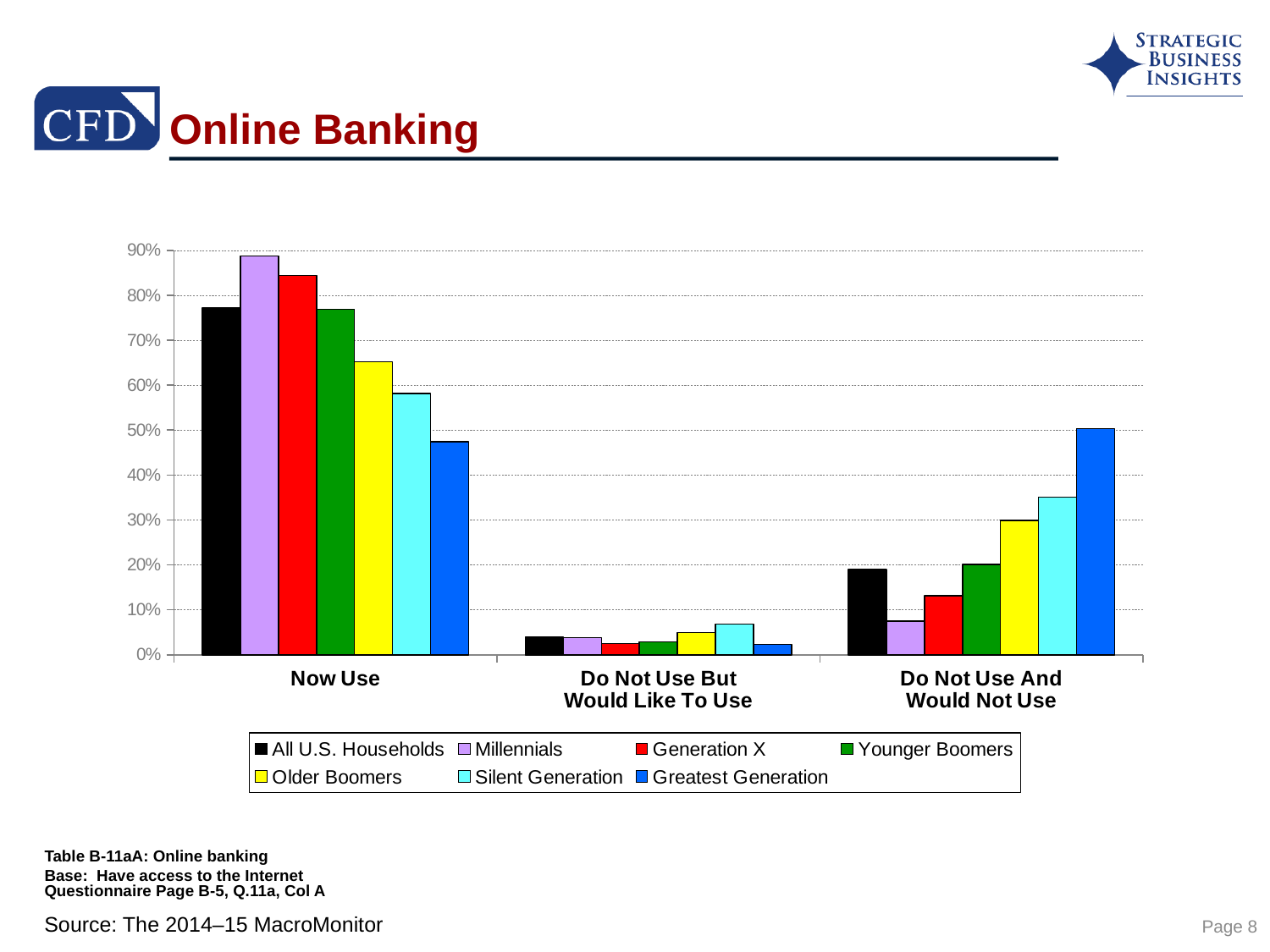
In the "Now Use" category, which series has the highest value? Millennials How many series does the legend list? 7 What is the title of the slide containing the chart? Online Banking How many categories are shown on the x axis? 3 In the "Do Not Use And Would Not Use" category, which series has the highest value? Greatest Generation What kind of chart is shown on the slide? Bar chart In the "Do Not Use And Would Not Use" category, which series has the lowest value? Millennials In the "Do Not Use And Would Not Use" category, which is larger: Silent Generation or Older Boomers? Silent Generation In the "Now Use" category, which series has the lowest value? Greatest Generation In the "Now Use" category, which is larger: Generation X or Younger Boomers? Generation X Is the value for Millennials in the "Now Use" category greater or less than 80%? greater Is the value for Greatest Generation in the "Now Use" category greater or less than 60%? less